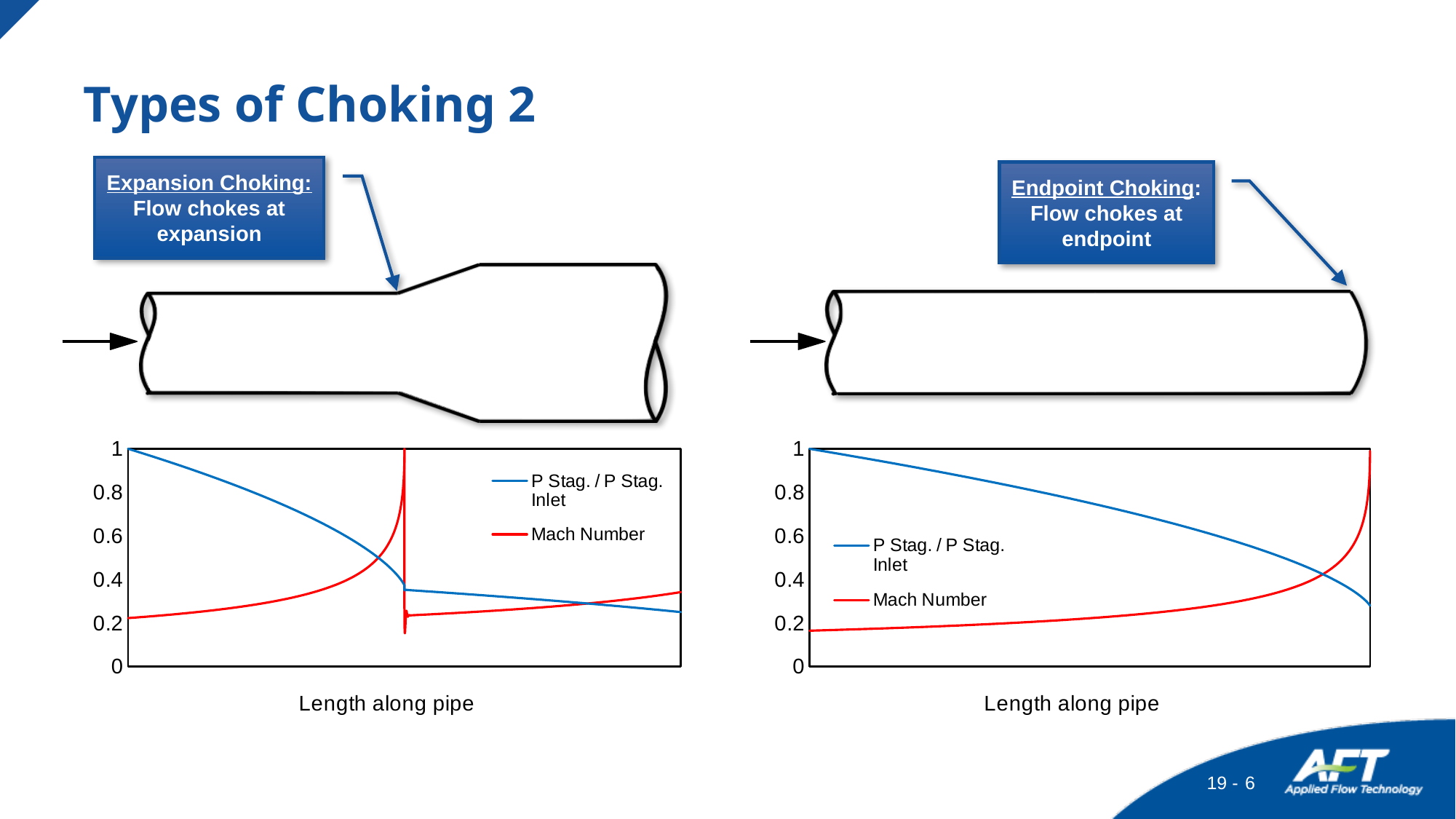
How many series does the legend of the right chart (Endpoint Choking) list? 2 In the right chart (Endpoint Choking), does the P Stag. / P Stag. Inlet series rise or fall along the length of the pipe? fall In the right chart (Endpoint Choking), is the P Stag. / P Stag. Inlet value at the end of the pipe greater or less than 0.4? less What is the x-axis label of the right chart (Endpoint Choking)? Length along pipe In the right chart (Endpoint Choking), is the Mach Number at the end of the pipe greater or less than 0.8? greater In the left chart (Expansion Choking), is the peak Mach Number at the expansion greater or less than 0.8? greater What are the two series named in the legend of the left chart (Expansion Choking)? P Stag. / P Stag. Inlet and Mach Number In the right chart (Endpoint Choking), what is the value of P Stag. / P Stag. Inlet at the start of the pipe? 1 What kind of chart is the left chart under the Expansion Choking diagram? line chart In the right chart (Endpoint Choking), does the Mach Number series rise or fall along the length of the pipe? rise In the left chart (Expansion Choking), what is the value of P Stag. / P Stag. Inlet at the start of the pipe? 1